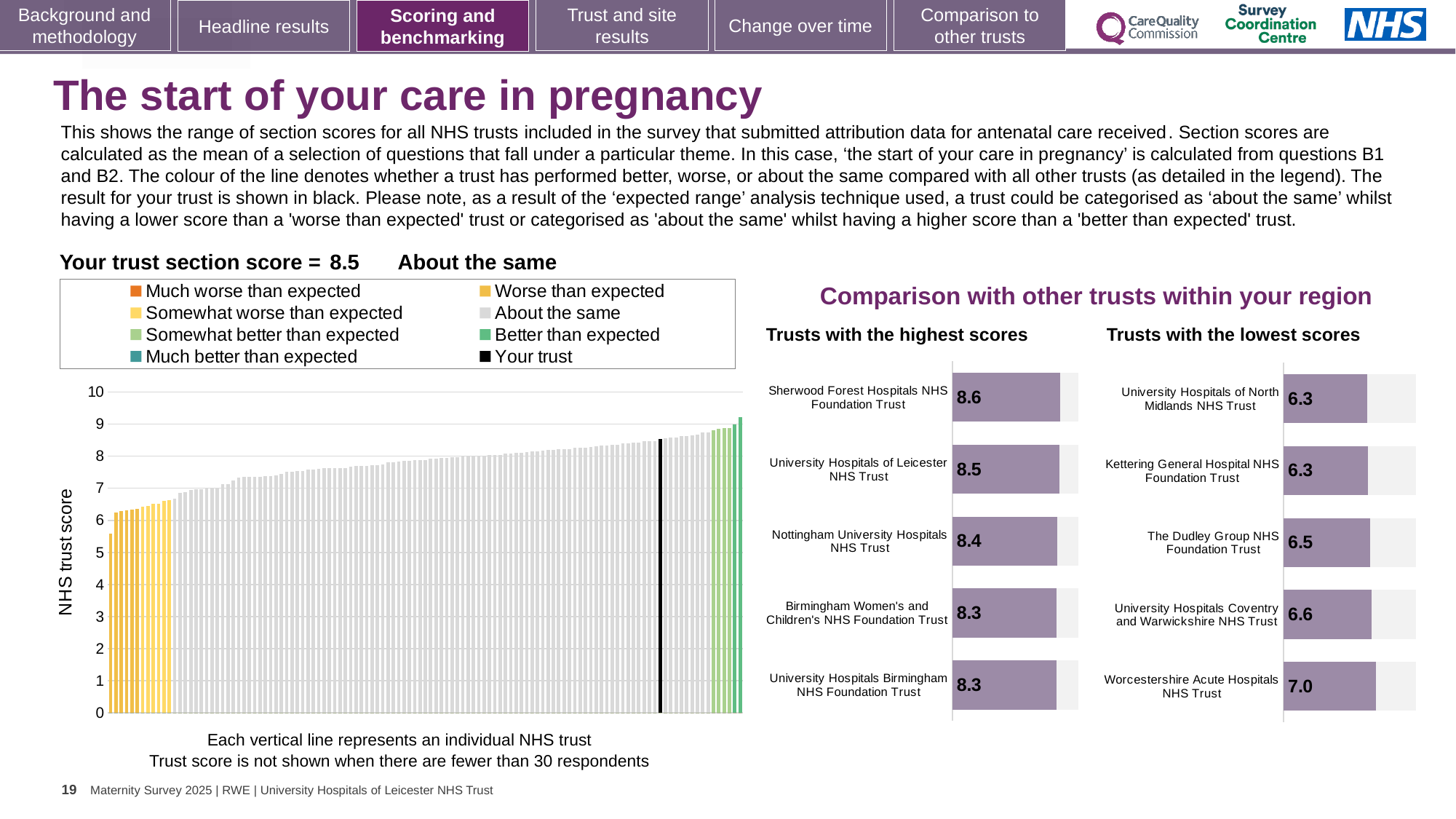
In the 'Trusts with the highest scores' chart, what is the score for Nottingham University Hospitals NHS Trust? 8.4 In the 'Trusts with the lowest scores' chart, which has the larger score: University Hospitals Coventry and Warwickshire NHS Trust or Kettering General Hospital NHS Foundation Trust? University Hospitals Coventry and Warwickshire NHS Trust How many trusts are shown in the 'Trusts with the lowest scores' chart? 5 How many entries does the legend of the large chart on the left list? 8 In the large chart on the left showing all NHS trusts, do the values rise or fall from left to right? rise In the 'Trusts with the lowest scores' chart, what is the score for The Dudley Group NHS Foundation Trust? 6.5 In the 'Trusts with the highest scores' chart, which trust has the highest score? Sherwood Forest Hospitals NHS Foundation Trust In the 'Trusts with the lowest scores' chart, which trust has the highest score? Worcestershire Acute Hospitals NHS Trust In the 'Trusts with the lowest scores' chart, what is the difference between the scores of Worcestershire Acute Hospitals NHS Trust and University Hospitals of North Midlands NHS Trust? 0.7 In the 'Trusts with the highest scores' chart, what is the difference between the scores of Sherwood Forest Hospitals NHS Foundation Trust and University Hospitals Birmingham NHS Foundation Trust? 0.3 In the large chart on the left showing all NHS trusts, is the value for the black bar (your trust) greater or less than 8? greater In the 'Trusts with the highest scores' chart, what is the score for Sherwood Forest Hospitals NHS Foundation Trust? 8.6